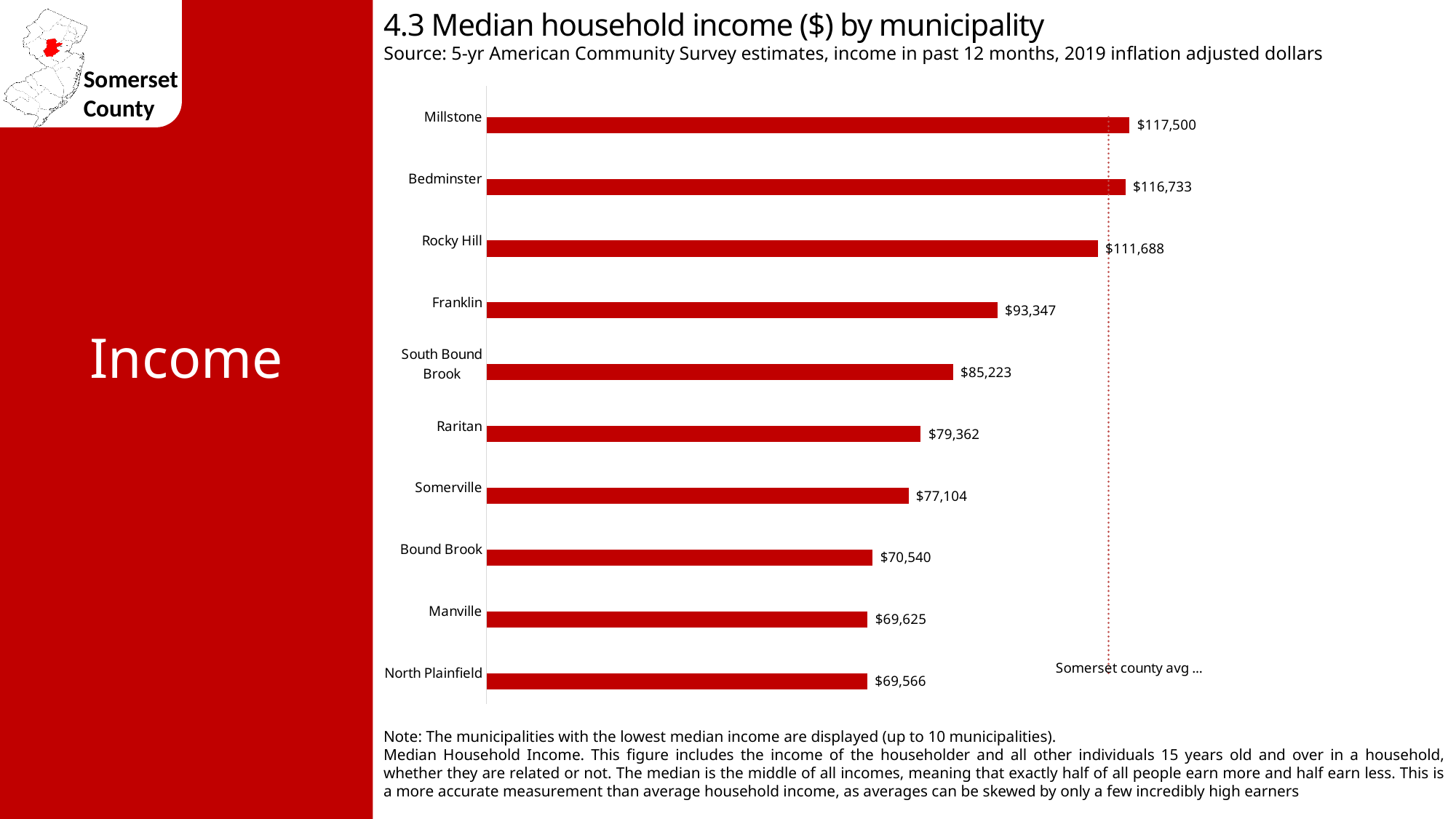
Which municipality has the lowest median household income shown on the chart? North Plainfield Which municipality has the highest median household income shown on the chart? Millstone What is the median household income for South Bound Brook? $85,223 What does the vertical dotted line on the chart represent? Somerset county avg What is the median household income for Manville? $69,625 Which has a higher median household income, Somerville or Bound Brook? Somerville What kind of chart is used to show median household income by municipality? Bar chart How many municipalities are shown on the chart? 10 What is the median household income for Franklin? $93,347 Which has a higher median household income, Rocky Hill or Franklin? Rocky Hill What is the difference between the median household income of Millstone and North Plainfield? $47,934 What is the difference between the median household income of Franklin and Raritan? $13,985